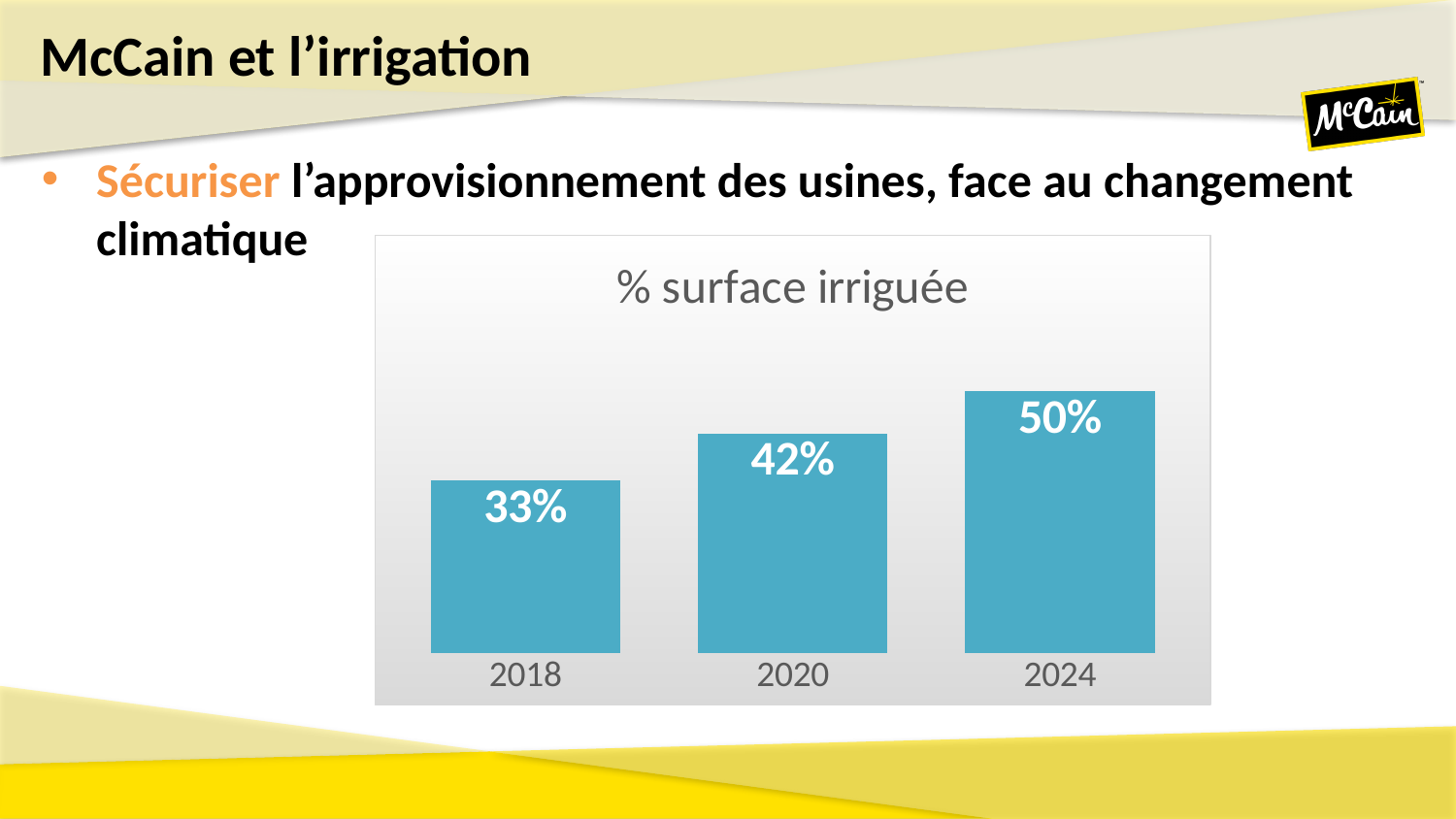
Which year has the lowest value? 2018 Which is larger, the value for 2020 or the value for 2024? 2024 What is the difference between the values for 2020 and 2018? 9% What is the value for 2020? 42% What kind of chart is shown? bar chart How many years are shown on the chart? 3 What is the difference between the values for 2024 and 2018? 17% Do the values rise or fall from 2018 to 2024? rise Which year has the highest value? 2024 What is the value for 2024? 50% What is the title of the chart? % surface irriguée What is the value for 2018? 33%